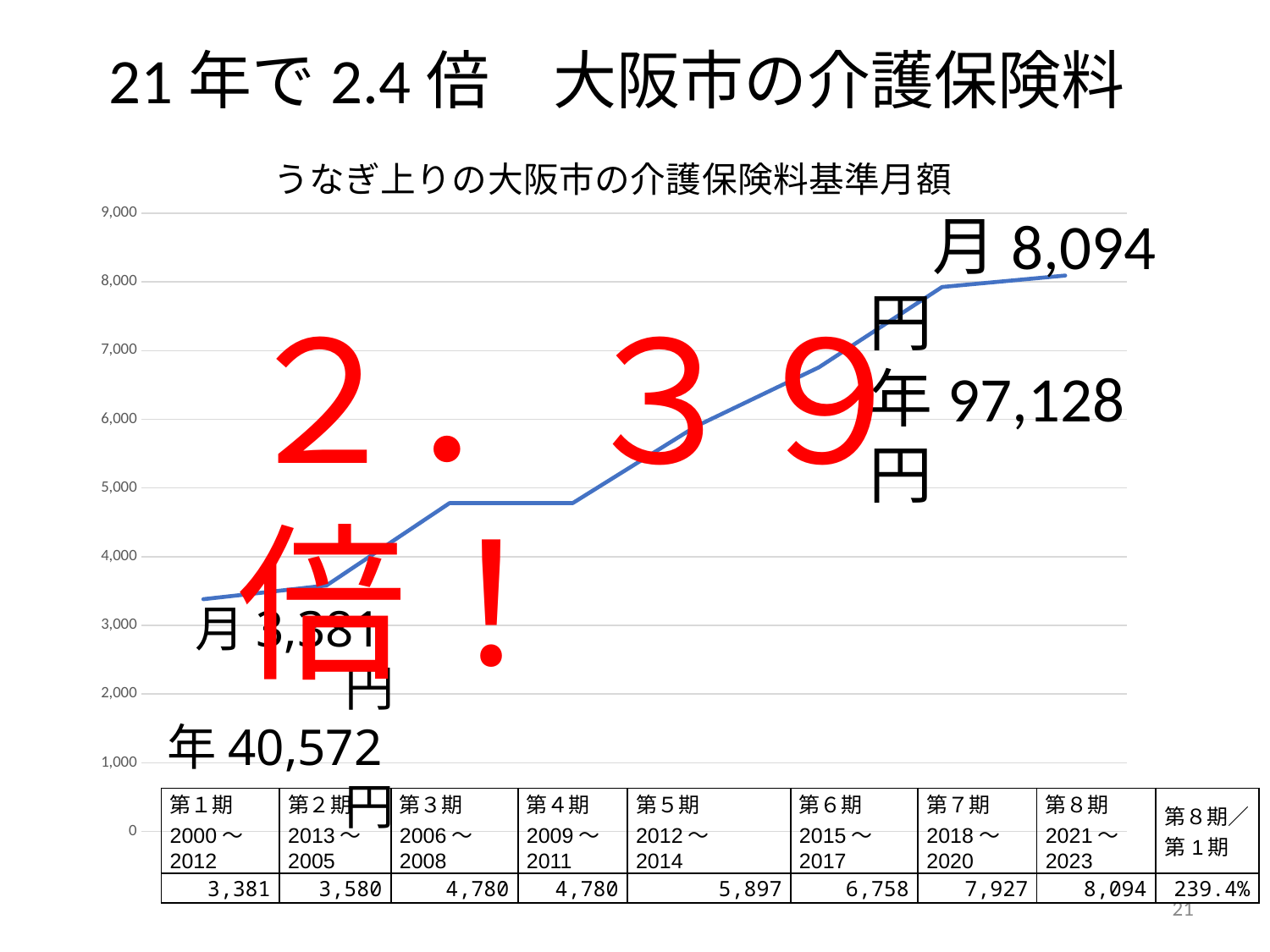
What is the value for 第1期 (2000～2012)? 3,381 How many periods are plotted on the chart? 8 What is the value for 第5期 (2012～2014)? 5,897 Is the value for 第3期 greater or less than 4,000? greater Which period has the highest value? 第8期 What is the difference between the values for 第8期 and 第1期? 4,713 What type of chart is shown on the slide? line chart Do the values generally rise or fall from 第1期 to 第8期? rise Which period has the lowest value? 第1期 What is the value for 第8期 (2021～2023)? 8,094 Which is larger, the value for 第6期 or the value for 第7期? 第7期 What is the chart's title? うなぎ上りの大阪市の介護保険料基準月額